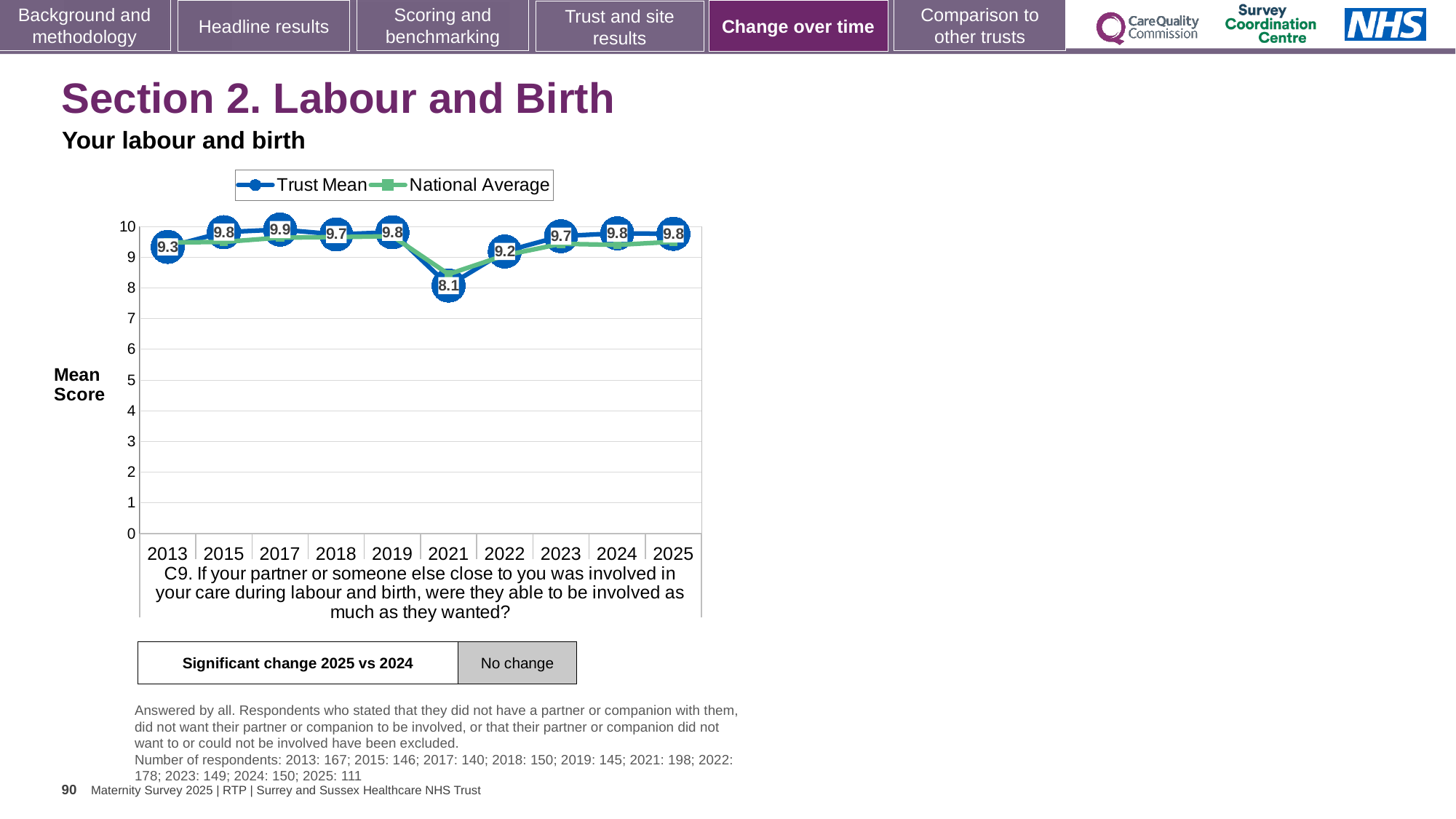
Does the Trust Mean rise or fall from 2021 to 2022? rise What is the Trust Mean value for 2025? 9.8 What kind of chart is shown? line chart What is the difference between the Trust Mean in 2017 and in 2021? 1.8 In which year is the Trust Mean highest? 2017 How many series does the legend list? 2 What is the Trust Mean value for 2021? 8.1 Is the National Average value for 2021 greater or less than 9? less In which year is the Trust Mean lowest? 2021 How many years are shown on the x axis? 10 What is the Trust Mean value for 2013? 9.3 Which year has the larger Trust Mean, 2013 or 2015? 2015